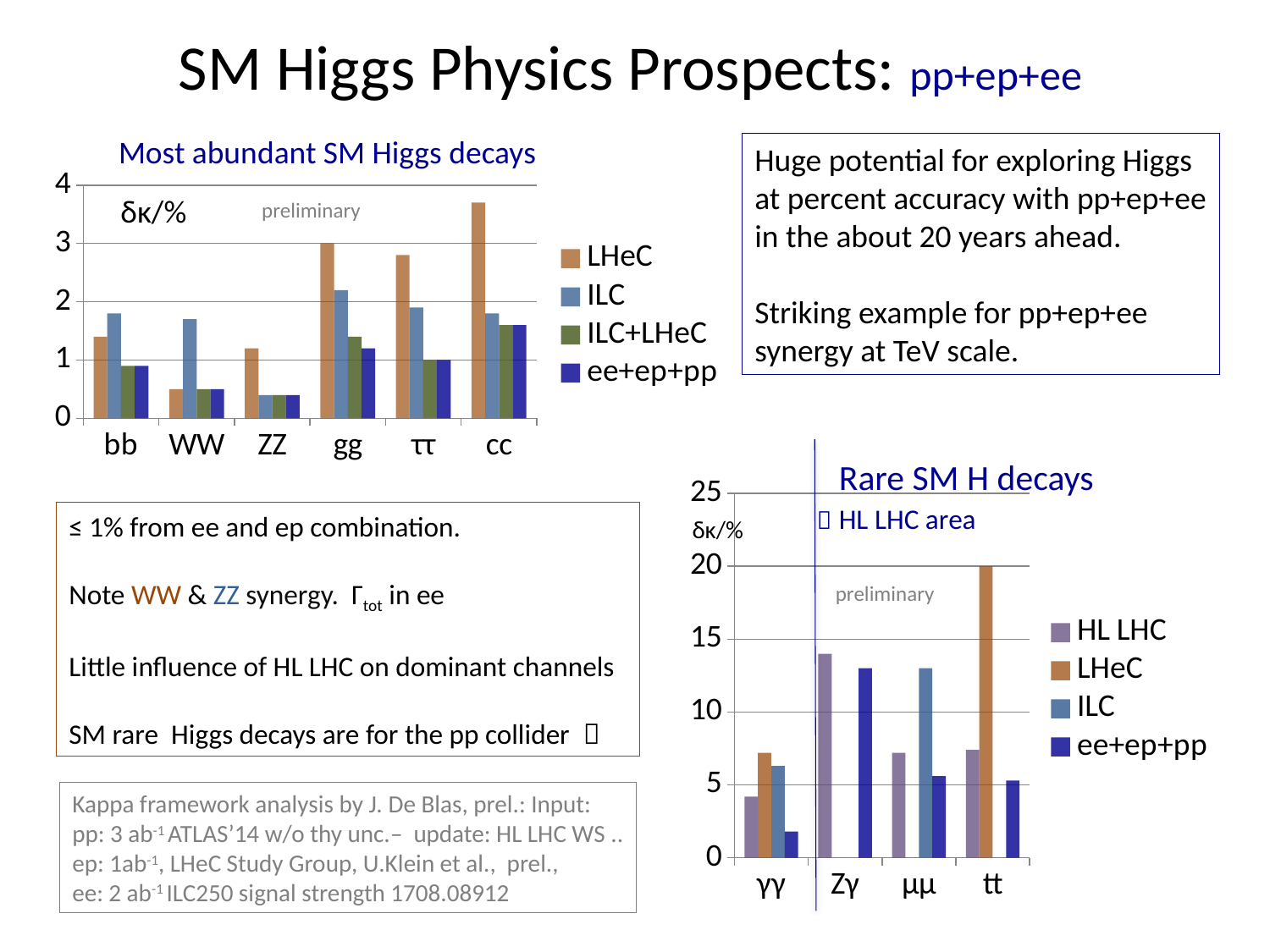
How many series does the legend of the 'Rare SM H decays' chart list? 4 How many series does the legend of the 'Most abundant SM Higgs decays' chart list? 4 How many decay categories are shown on the x axis of the 'Most abundant SM Higgs decays' chart? 6 In the 'Rare SM H decays' chart, which is larger for γγ: the HL LHC value or the ee+ep+pp value? HL LHC In the 'Most abundant SM Higgs decays' chart, is the ILC value for ZZ greater or less than 1? less In the 'Rare SM H decays' chart, which category has the highest LHeC value? tt In the 'Most abundant SM Higgs decays' chart, which is larger for WW: the LHeC value or the ILC value? ILC How many decay categories are shown on the x axis of the 'Rare SM H decays' chart? 4 In the 'Rare SM H decays' chart, is the LHeC value for tt greater or less than 15? greater In the 'Most abundant SM Higgs decays' chart, is the LHeC value for cc greater or less than 3? greater What type of chart is the 'Most abundant SM Higgs decays' chart? bar chart In the 'Most abundant SM Higgs decays' chart, which category has the highest LHeC value? cc